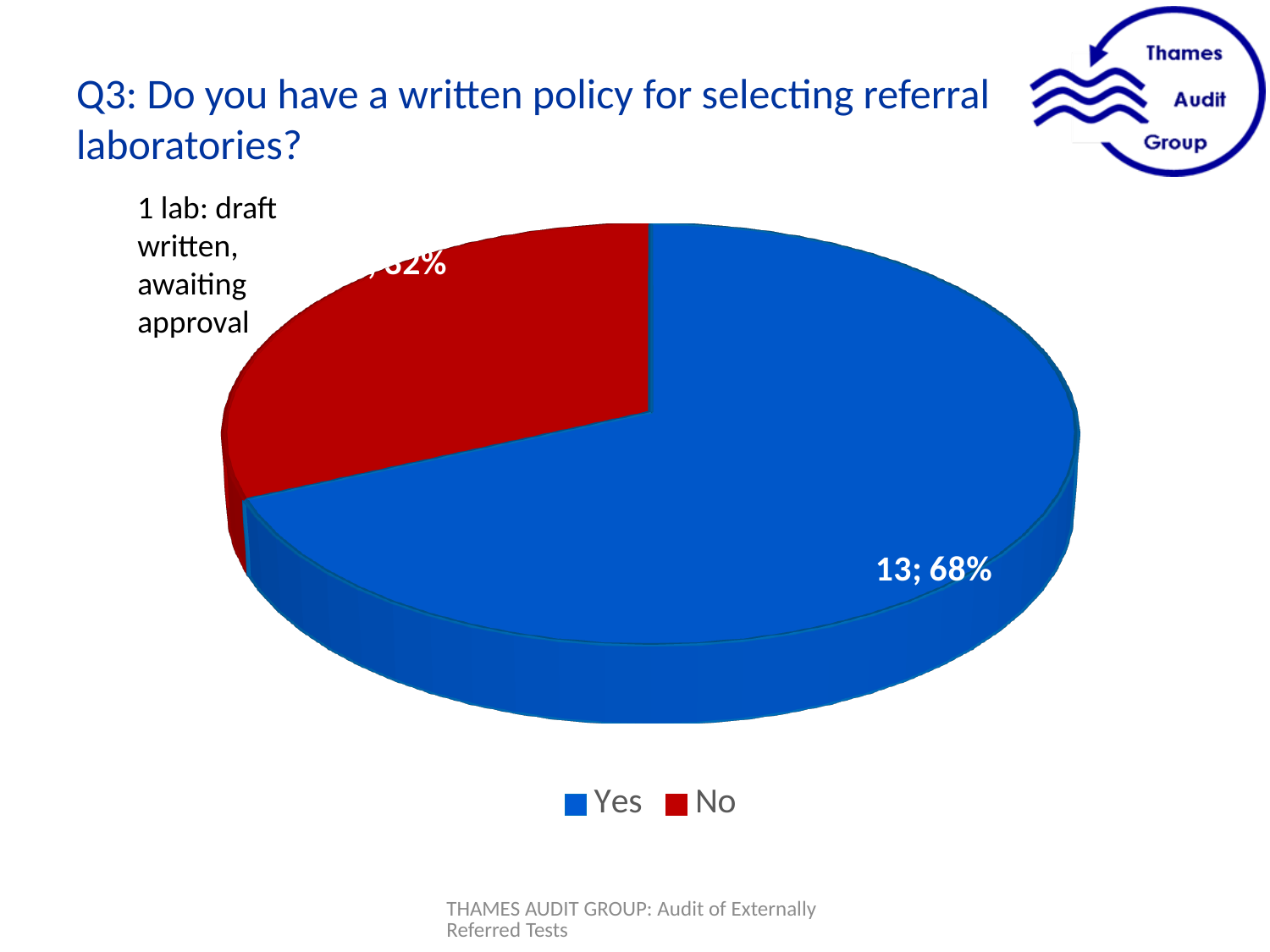
What percentage of the pie does the No slice represent? 32% How many slices does the pie chart have? 2 Is the share for Yes larger or smaller than the share for No? larger What question does the chart title say the pie chart is about? Q3: Do you have a written policy for selecting referral laboratories? How many labs answered Yes to having a written policy for selecting referral laboratories? 13 What percentage of the pie does the Yes slice represent? 68% By how many percentage points does the Yes share exceed the No share? 36 percentage points What kind of chart is shown on the slide? pie chart Which response has the smallest slice of the pie? No What colour is the Yes slice in the pie chart? blue How many entries does the legend list? 2 Which response, Yes or No, has the larger share of the pie? Yes